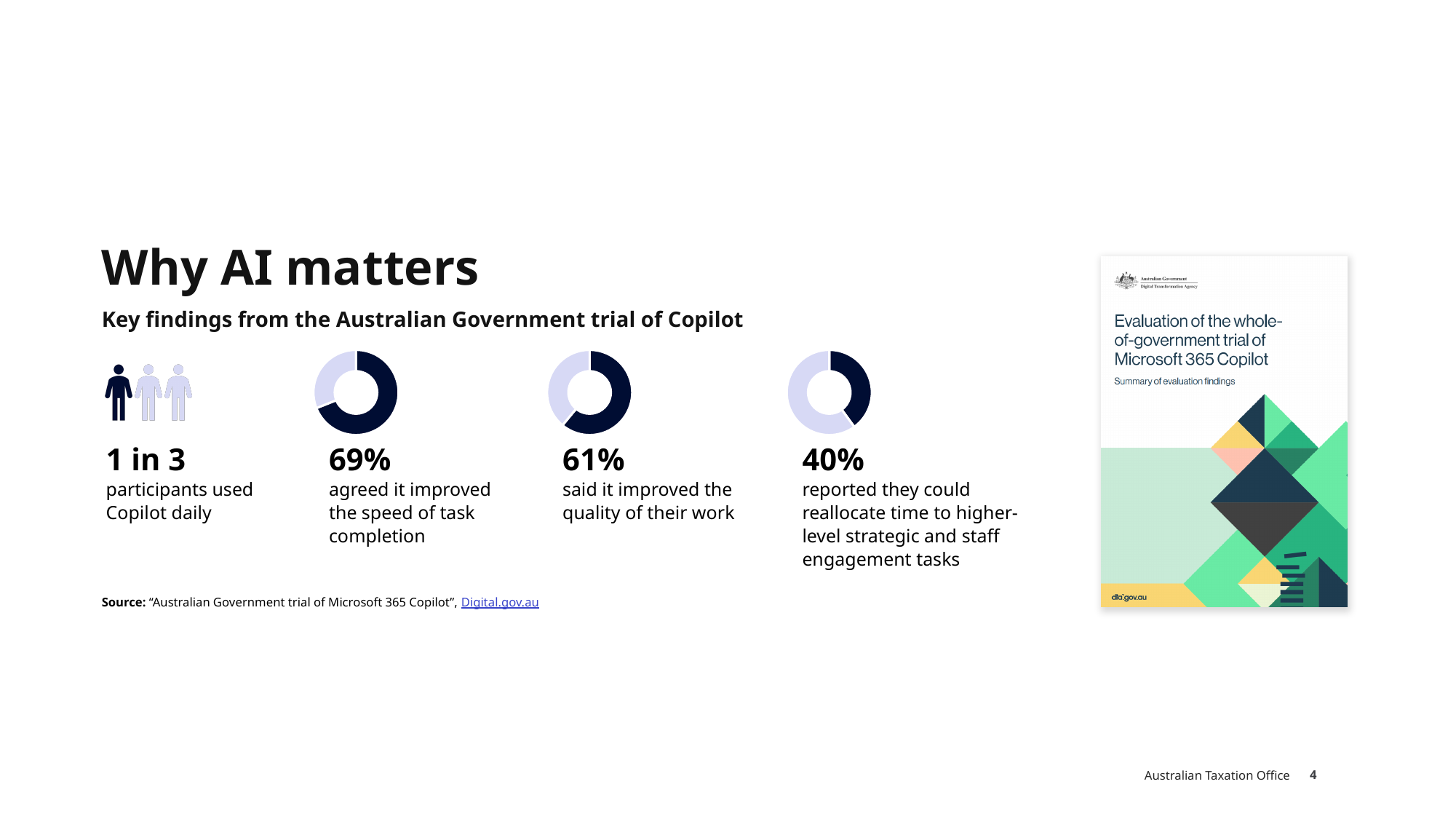
What share of the third donut chart is filled with the dark colour? 40% What is the difference in percentage points between those who said it improved quality of their work and those who reported they could reallocate time to higher-level tasks? 21 What proportion of participants used Copilot daily? 1 in 3 Which is larger: the percentage who said it improved the quality of their work, or the percentage who reported they could reallocate time to higher-level tasks? said it improved the quality of their work How many donut charts are shown on the slide? 3 Which finding has the lowest percentage among the three donut charts? reported they could reallocate time to higher-level strategic and staff engagement tasks Which finding has the highest percentage among the three donut charts? agreed it improved the speed of task completion What percentage of participants reported they could reallocate time to higher-level strategic and staff engagement tasks? 40% What percentage of participants said Copilot improved the quality of their work? 61% What is the difference in percentage points between those who agreed it improved speed of task completion and those who said it improved quality of their work? 8 What percentage of participants agreed Copilot improved the speed of task completion? 69% What kind of chart is used to show the 69%, 61% and 40% findings? donut chart